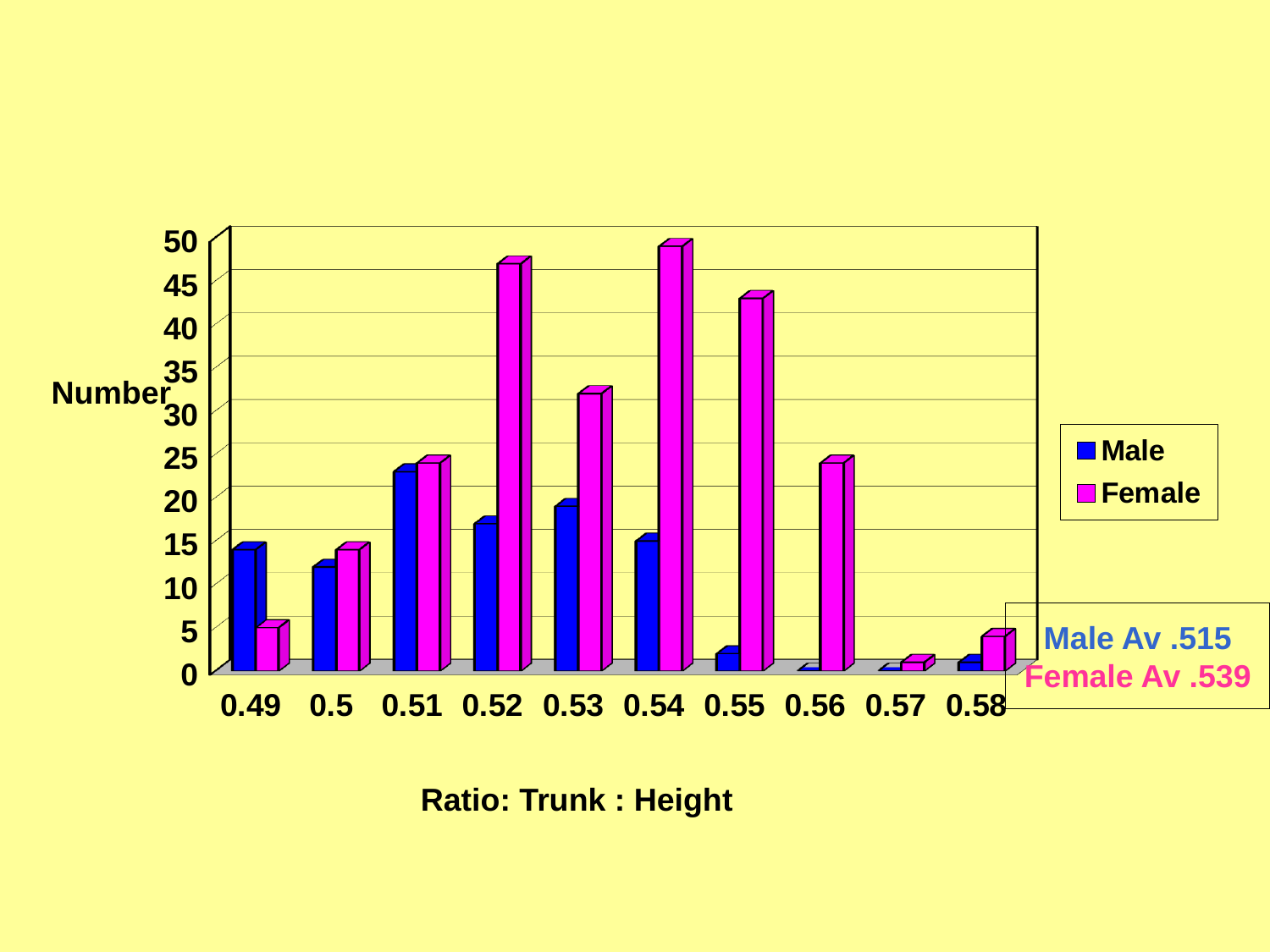
For which ratio category is the Male bar highest? 0.51 Is the Male value at ratio 0.49 greater or less than 10? greater At ratio 0.53, which series has the larger value, Male or Female? Female What kind of chart is shown on the slide? bar chart What is the Male average ratio stated on the slide? .515 At ratio 0.49, which series has the larger value, Male or Female? Male What is the title of the x axis? Ratio: Trunk : Height How many ratio categories are shown along the x axis? 10 Is the Female value at ratio 0.52 greater or less than 40? greater Is the Female value at ratio 0.49 greater or less than 10? less How many series does the legend list? 2